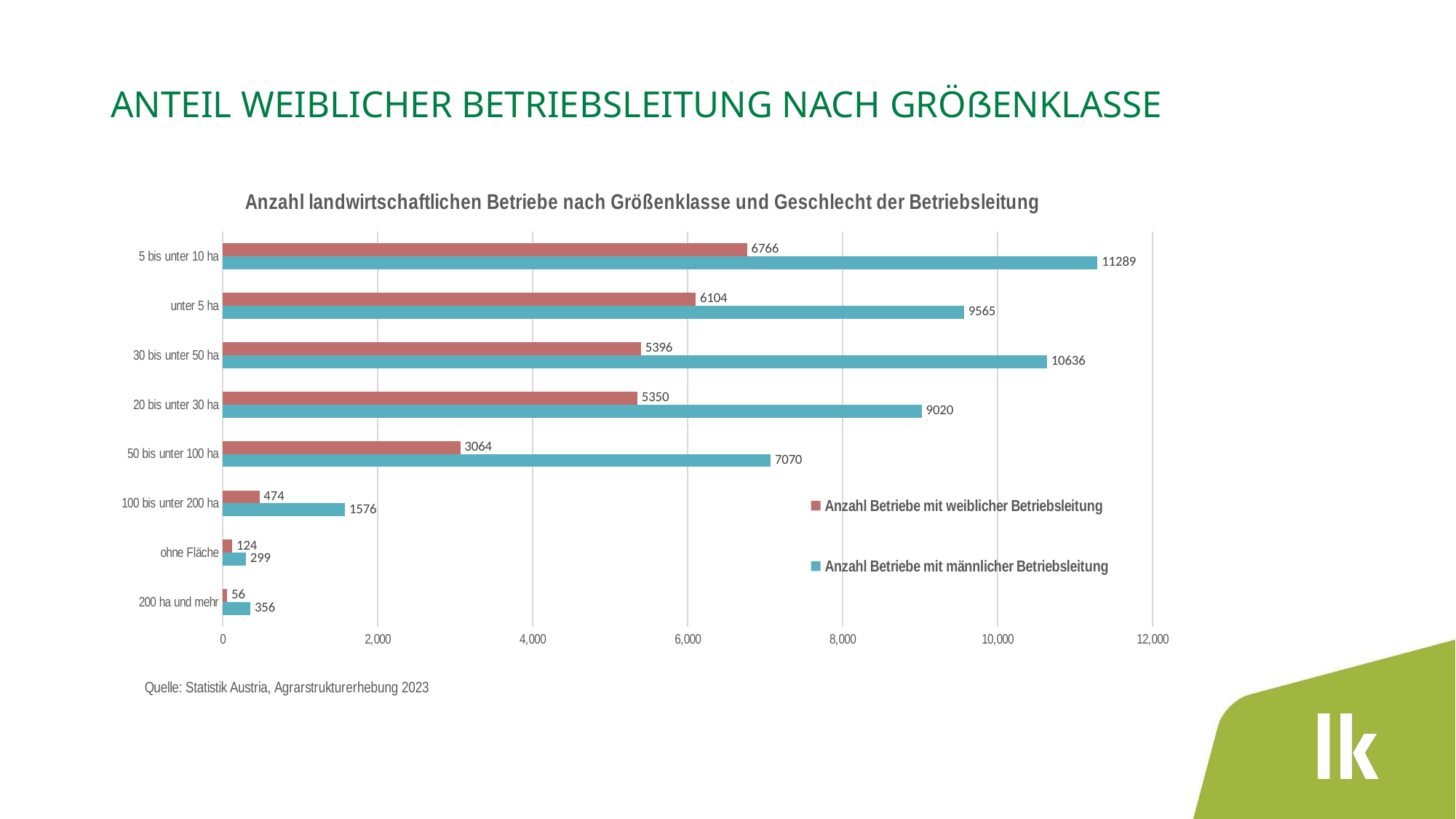
What kind of chart is shown on the slide? Bar chart How many series does the legend list? 2 What is the title of the chart? Anzahl landwirtschaftlichen Betriebe nach Größenklasse und Geschlecht der Betriebsleitung Which size class has the lowest number of farms with female management? 200 ha und mehr Which size class has the highest number of farms with male management? 5 bis unter 10 ha What is the number of farms with male management (Anzahl Betriebe mit männlicher Betriebsleitung) in the '30 bis unter 50 ha' size class? 10636 Is the number of male-managed farms in the '20 bis unter 30 ha' size class greater or less than 8,000? greater What is the difference between the number of male-managed and female-managed farms in the 'unter 5 ha' size class? 3461 What is the total number of farms (female plus male management) in the 'ohne Fläche' category? 423 How many size classes (categories) are shown on the chart? 8 What is the number of farms with female management (Anzahl Betriebe mit weiblicher Betriebsleitung) in the '5 bis unter 10 ha' size class? 6766 Which is larger: the number of female-managed farms in '20 bis unter 30 ha' or in '50 bis unter 100 ha'? 20 bis unter 30 ha